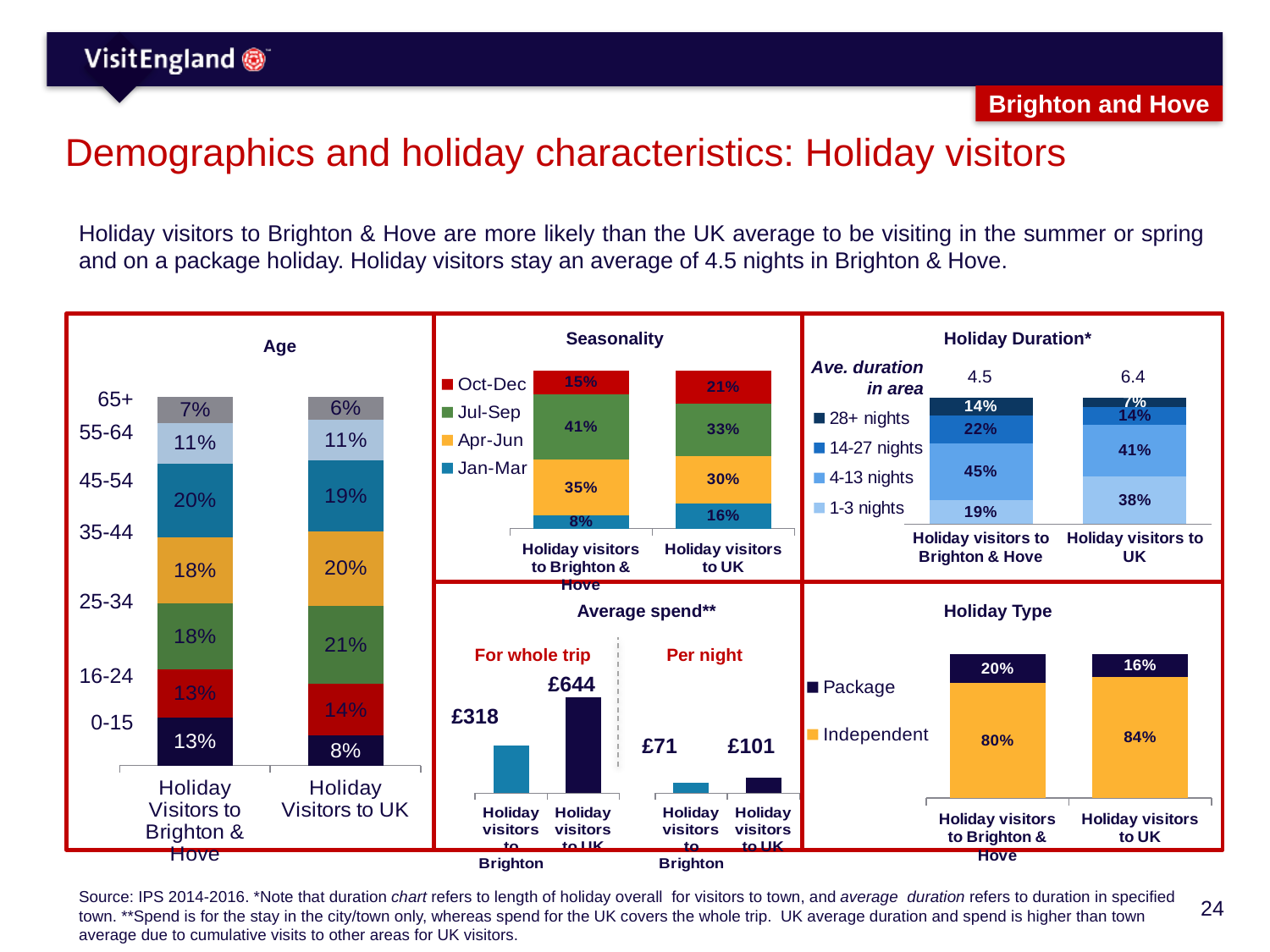
In the Average spend chart, which is larger: the per night spend for holiday visitors to Brighton or for holiday visitors to the UK? Holiday visitors to UK In the Average spend chart, what is the average spend for the whole trip for holiday visitors to the UK? £644 In the Holiday Duration chart, what is the average duration in area for holiday visitors to Brighton & Hove? 4.5 In the Age chart, how many age groups does the axis list? 7 In the Seasonality chart, what percentage of holiday visitors to Brighton & Hove visit in Jul-Sep? 41% In the Holiday Duration chart, what percentage of holiday visitors to the UK stay 1-3 nights? 38% In the Age chart, what percentage of holiday visitors to Brighton & Hove are aged 0-15? 13% In the Age chart, which age group has the largest share among holiday visitors to the UK? 25-34 In the Seasonality chart, how many series does the legend list? 4 In the Holiday Type chart, what percentage of holiday visitors to Brighton & Hove are on a package holiday? 20% What kind of chart is the Holiday Type chart? Stacked bar chart In the Seasonality chart, what is the difference between the Jan-Mar share for holiday visitors to the UK and for holiday visitors to Brighton & Hove? 8%